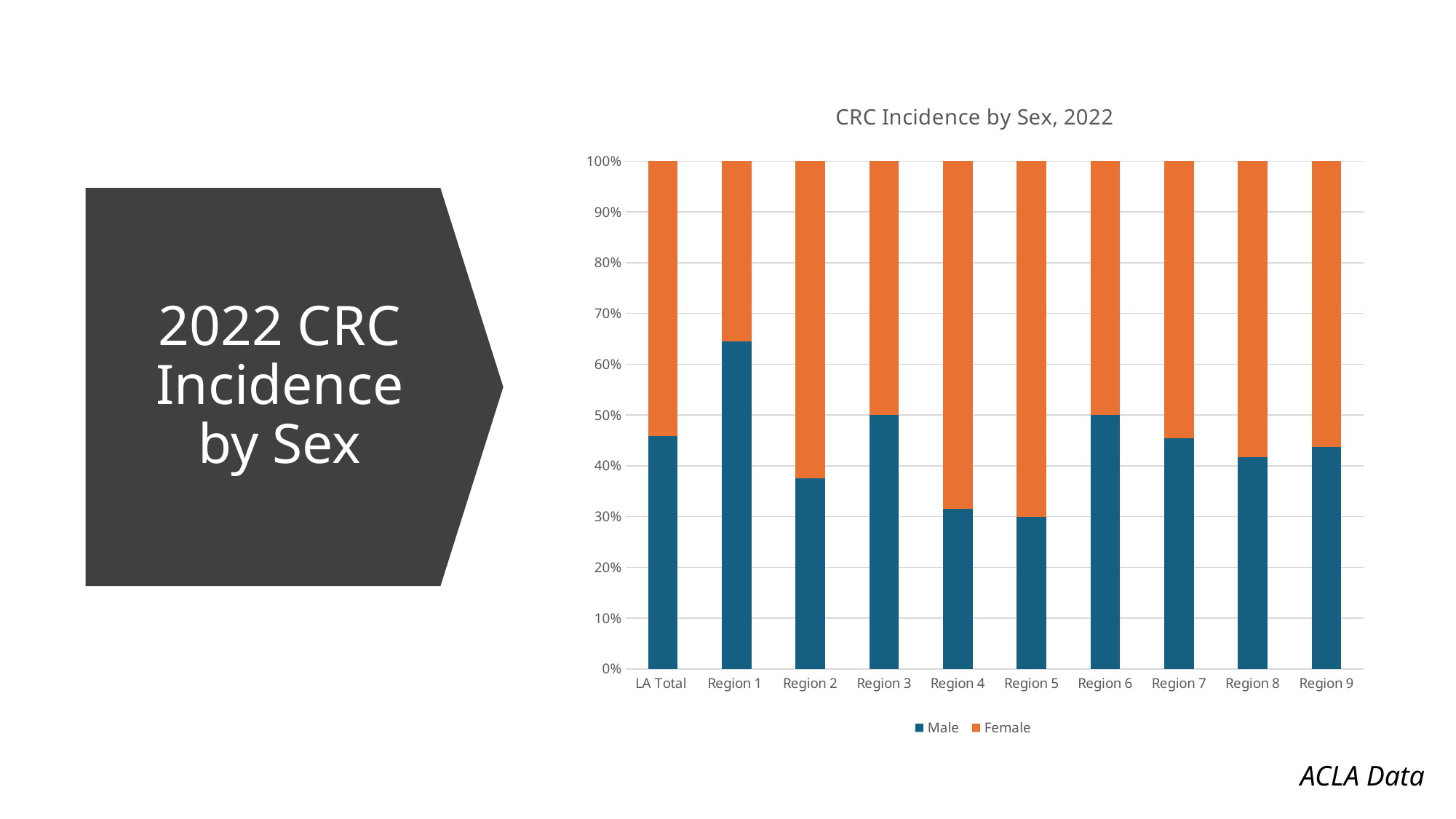
What is the title of the chart? CRC Incidence by Sex, 2022 Which category has the highest Male share? Region 1 Is the Male value for Region 8 greater or less than 40%? greater Which has the larger Female share, Region 3 or Region 4? Region 4 Which has the larger Male share, Region 1 or Region 2? Region 1 How many categories are shown on the x axis of the chart? 10 What kind of chart is shown on the slide? Stacked bar chart What is the total of the stacked bar for Region 1? 100% How many series does the chart's legend list? 2 Is the Male value for Region 5 greater or less than 40%? less Is the Male value for Region 1 greater or less than 60%? greater